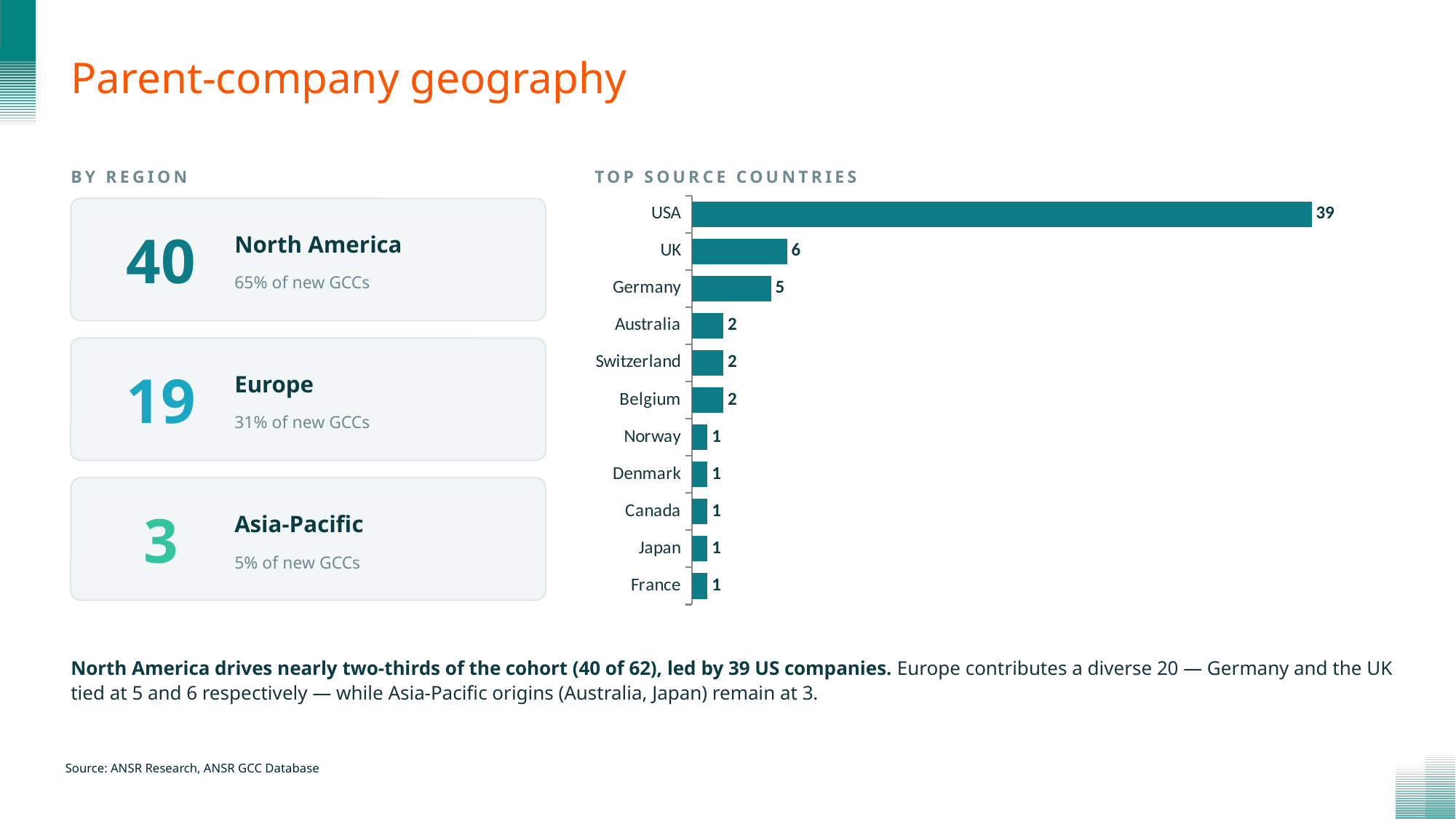
In the Top Source Countries chart, how many countries have a value of 1? 5 In the Top Source Countries chart, what is the difference between the values for USA and UK? 33 What kind of chart is the Top Source Countries chart? Bar chart In the Top Source Countries chart, which country has the highest value? USA What is the title of the bar chart on the right of the slide? Top Source Countries In the Top Source Countries chart, what is the value for Belgium? 2 In the Top Source Countries chart, what is the value for UK? 6 In the Top Source Countries chart, what is the value for Germany? 5 In the Top Source Countries chart, what is the value for USA? 39 In the Top Source Countries chart, which is larger, the value for UK or the value for Germany? UK In the Top Source Countries chart, how many countries are shown? 11 In the Top Source Countries chart, what is the difference between the values for Germany and Australia? 3